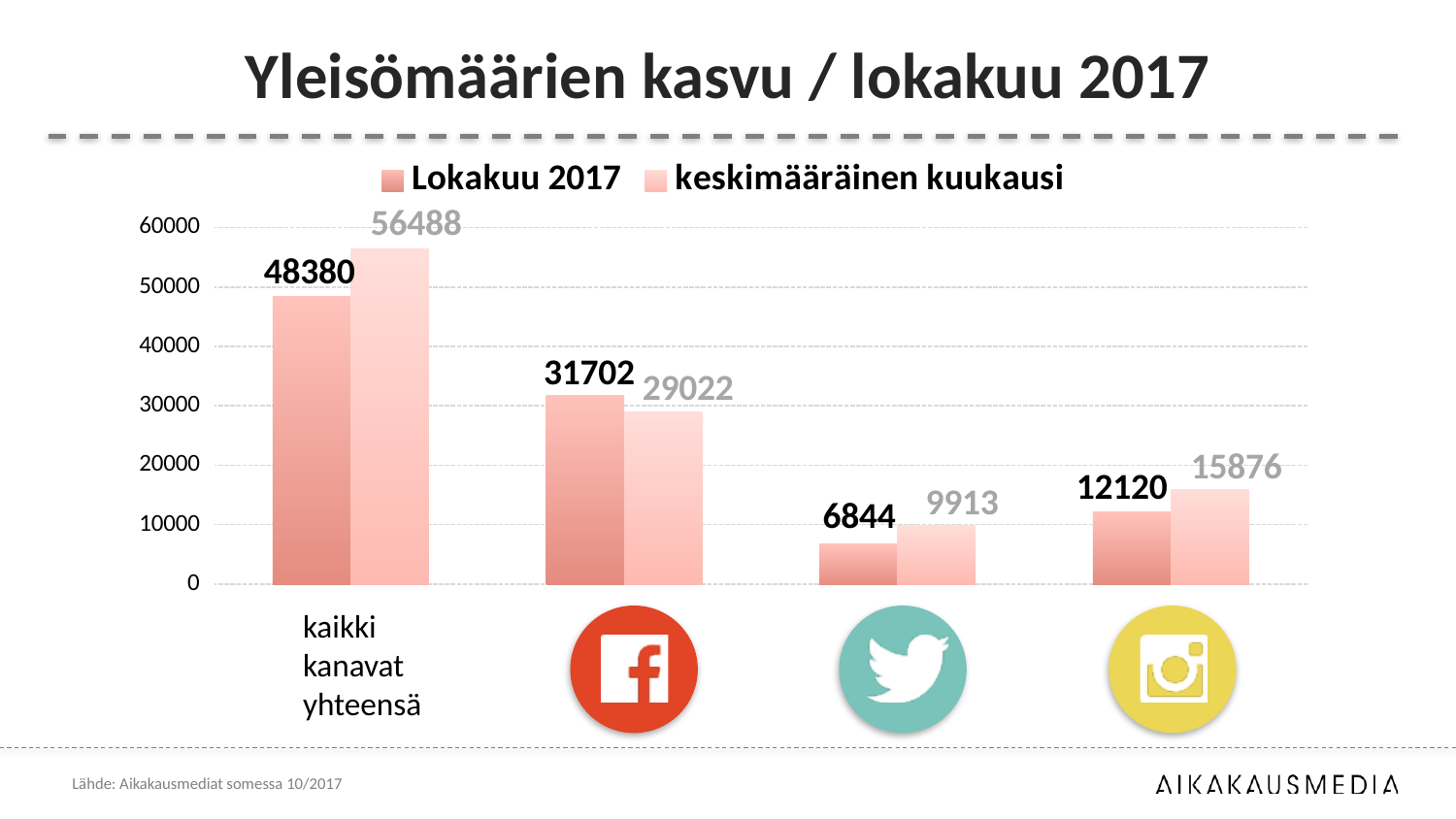
Is the Lokakuu 2017 value for the Instagram category greater or less than 10000? greater What is the difference between the keskimääräinen kuukausi and Lokakuu 2017 values for kaikki kanavat yhteensä? 8108 What is the value for Lokakuu 2017 for kaikki kanavat yhteensä? 48380 What is the keskimääräinen kuukausi value for the Instagram category? 15876 How many categories are shown on the x axis? 4 For the Facebook category, which is larger: Lokakuu 2017 or keskimääräinen kuukausi? Lokakuu 2017 Which category has the lowest Lokakuu 2017 value? Twitter What kind of chart is shown on the slide? bar chart How many series does the legend list? 2 What is the value for keskimääräinen kuukausi for the Facebook category? 29022 Which category has the highest keskimääräinen kuukausi value? kaikki kanavat yhteensä What is the Lokakuu 2017 value for the Twitter category? 6844